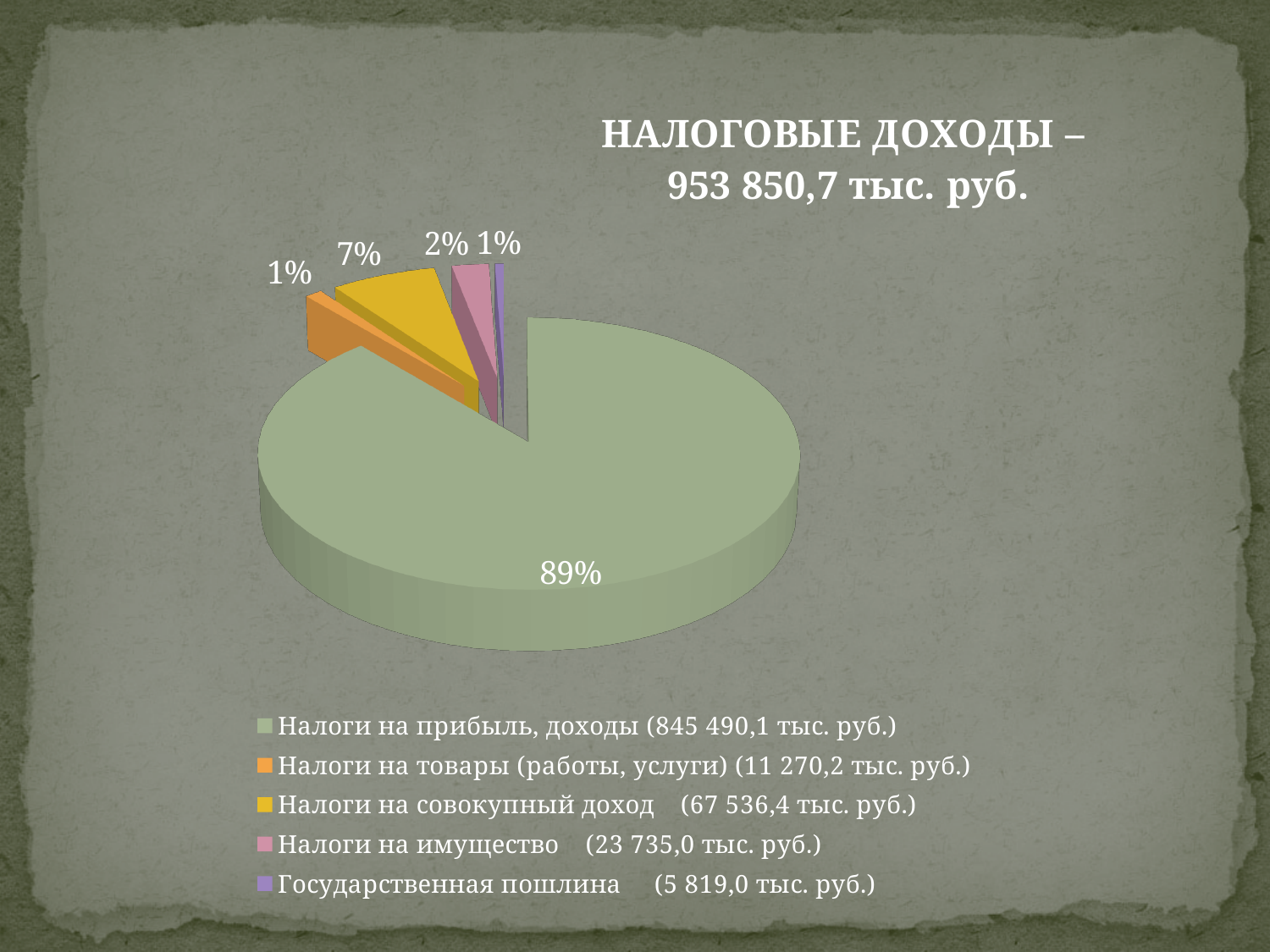
How many entries does the legend list? 5 What total amount of tax revenue is stated in the chart title? 953 850,7 тыс. руб. What share of the pie does "Налоги на прибыль, доходы" take? 89% What share of the pie does "Налоги на имущество" take? 2% What amount is given in the legend for "Налоги на товары (работы, услуги)"? 11 270,2 тыс. руб. How many slices does the pie chart have? 5 By how many percentage points does the share of "Налоги на совокупный доход" exceed the share of "Налоги на имущество"? 5 What kind of chart is shown on the slide? pie chart Which is larger: the share for "Налоги на совокупный доход" or the share for "Налоги на имущество"? Налоги на совокупный доход What amount is given in the legend for "Государственная пошлина"? 5 819,0 тыс. руб. Which category has the largest slice of the pie? Налоги на прибыль, доходы What share of the pie does "Налоги на совокупный доход" take? 7%